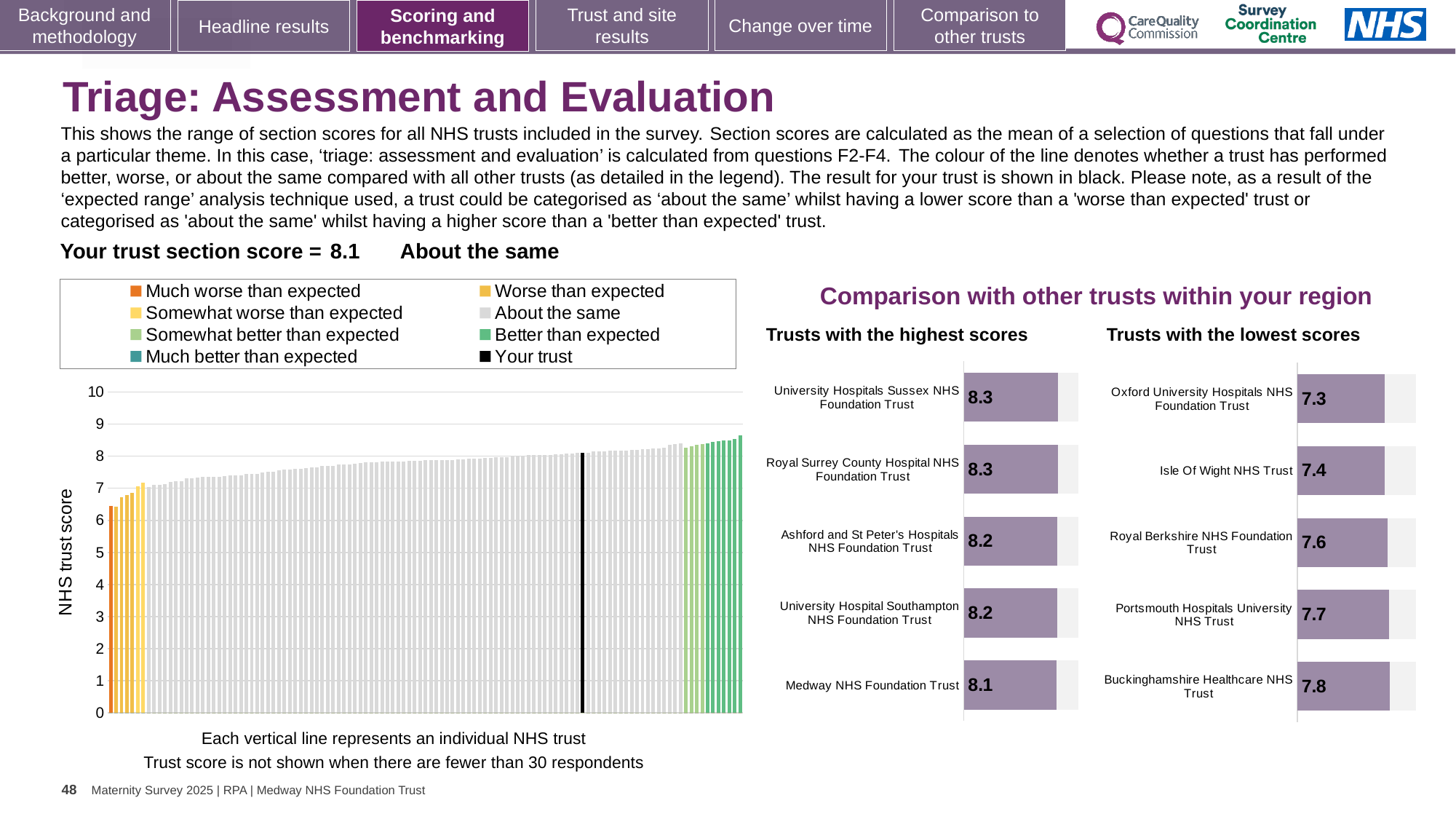
In the main NHS trust score chart on the left, do the values rise or fall from left to right along the x axis? rise In the main NHS trust score chart on the left, is the value for the lowest-scoring trust (the leftmost bar) greater or less than 7? less In the 'Trusts with the lowest scores' chart, what is the score for Portsmouth Hospitals University NHS Trust? 7.7 In the 'Trusts with the highest scores' chart, what is the score for University Hospitals Sussex NHS Foundation Trust? 8.3 In the 'Trusts with the lowest scores' chart, which has the larger score: Isle Of Wight NHS Trust or Royal Berkshire NHS Foundation Trust? Royal Berkshire NHS Foundation Trust In the 'Trusts with the lowest scores' chart, which trust has the highest score? Buckinghamshire Healthcare NHS Trust In the 'Trusts with the lowest scores' chart, what is the score for Oxford University Hospitals NHS Foundation Trust? 7.3 How many trusts are shown in the 'Trusts with the highest scores' chart? 5 In the 'Trusts with the highest scores' chart, what is the score for Medway NHS Foundation Trust? 8.1 In the 'Trusts with the lowest scores' chart, which trust has the lowest score? Oxford University Hospitals NHS Foundation Trust In the 'Trusts with the lowest scores' chart, what is the difference between the scores of Buckinghamshire Healthcare NHS Trust and Oxford University Hospitals NHS Foundation Trust? 0.5 How many entries does the legend of the main NHS trust score chart list? 8